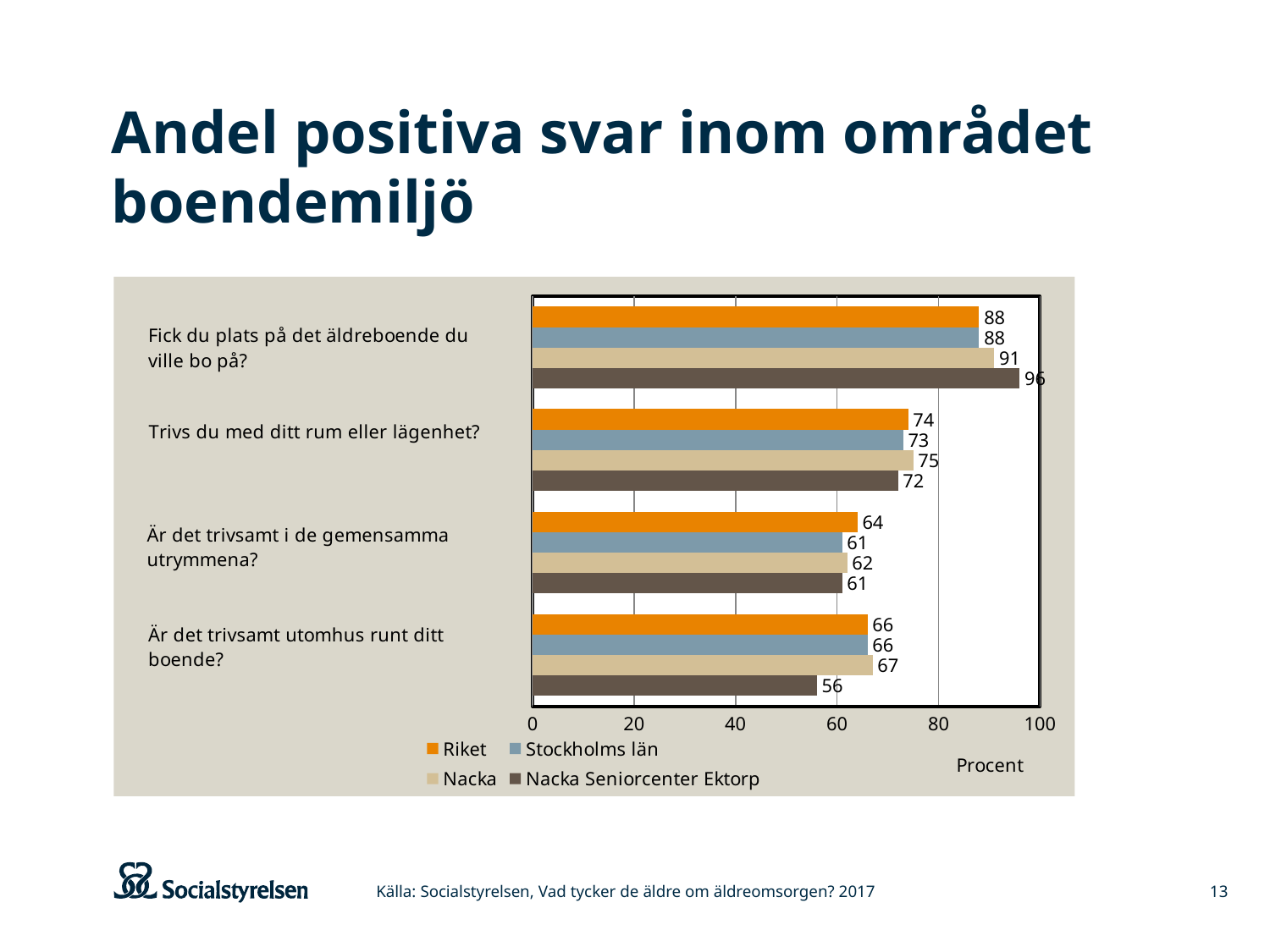
What is the value for Stockholms län on the question "Är det trivsamt i de gemensamma utrymmena?"? 61 Which series has the highest value on the question "Fick du plats på det äldreboende du ville bo på?"? Nacka Seniorcenter Ektorp Which series has the lowest value on the question "Är det trivsamt utomhus runt ditt boende?"? Nacka Seniorcenter Ektorp On the question "Är det trivsamt utomhus runt ditt boende?", which is larger: the value for Nacka or the value for Nacka Seniorcenter Ektorp? Nacka How many series does the legend list? 4 What is the value for Nacka Seniorcenter Ektorp on the question "Fick du plats på det äldreboende du ville bo på?"? 96 What kind of chart is shown on the slide? Bar chart What is the value for Nacka Seniorcenter Ektorp on the question "Är det trivsamt utomhus runt ditt boende?"? 56 What is the value for Nacka on the question "Trivs du med ditt rum eller lägenhet?"? 75 What is the label on the horizontal axis of the chart? Procent What is the difference between the Nacka Seniorcenter Ektorp value and the Riket value on the question "Fick du plats på det äldreboende du ville bo på?"? 8 How many questions (categories) are shown in the chart? 4